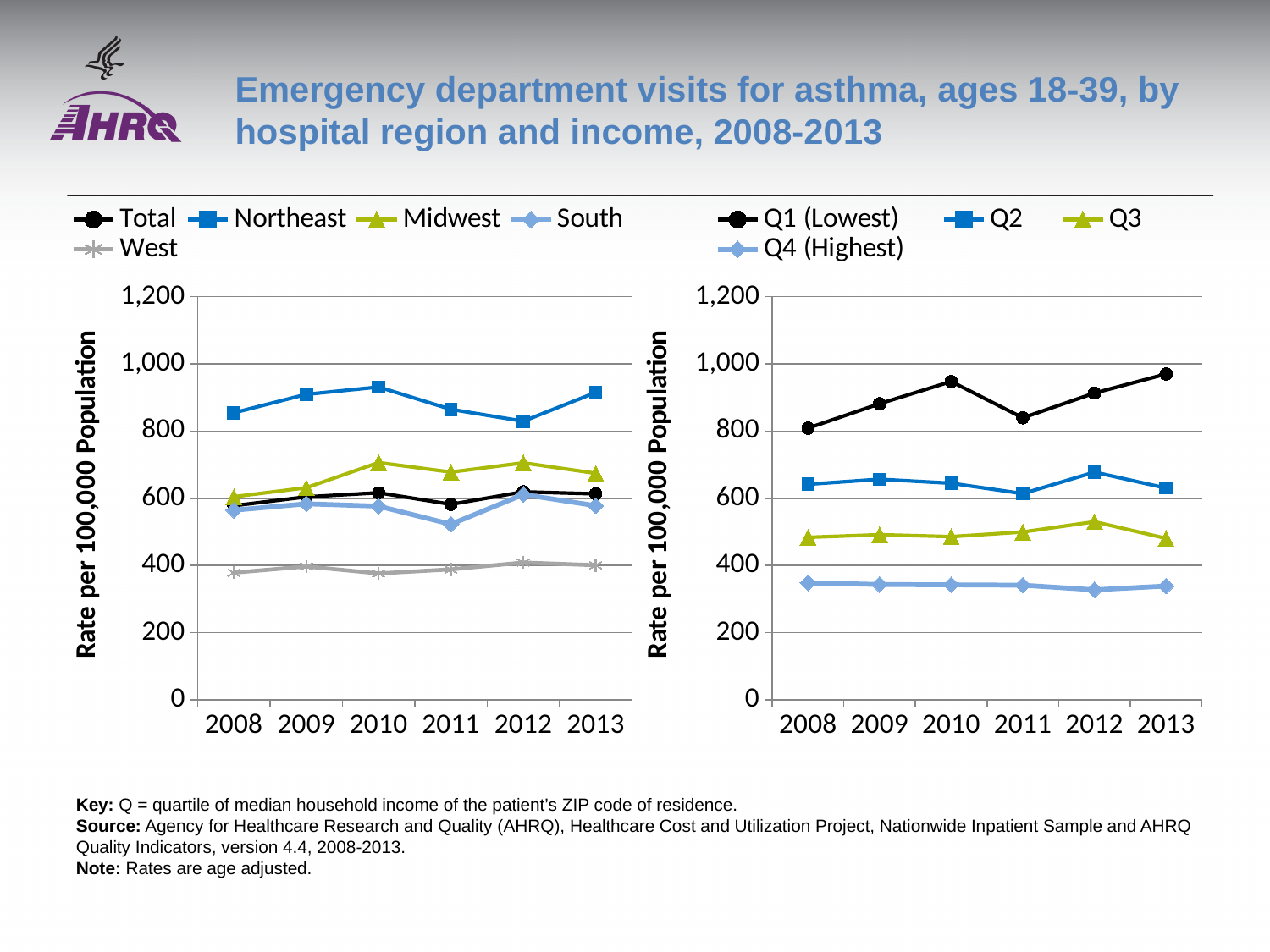
In the left chart, is the value for Northeast in 2010 greater or less than 800? greater In the left chart, which region has the highest rate in every year shown? Northeast In the left chart, is the value for West in 2008 greater or less than 400? less How many series does the legend of the left chart list? 5 In the right chart, which income quartile has the lowest rate in every year shown? Q4 (Highest) In the right chart, is the value for Q1 (Lowest) in 2013 greater or less than 800? greater How many years are shown on the x axis of the right chart? 6 In the left chart, which is larger in 2012, the value for Midwest or the value for South? Midwest In the right chart, does the Q1 (Lowest) line rise or fall from 2011 to 2013? rise In the right chart, which income quartile has the highest rate in 2013? Q1 (Lowest) What kind of chart is the left chart on the slide? line chart How many series does the legend of the right chart list? 4